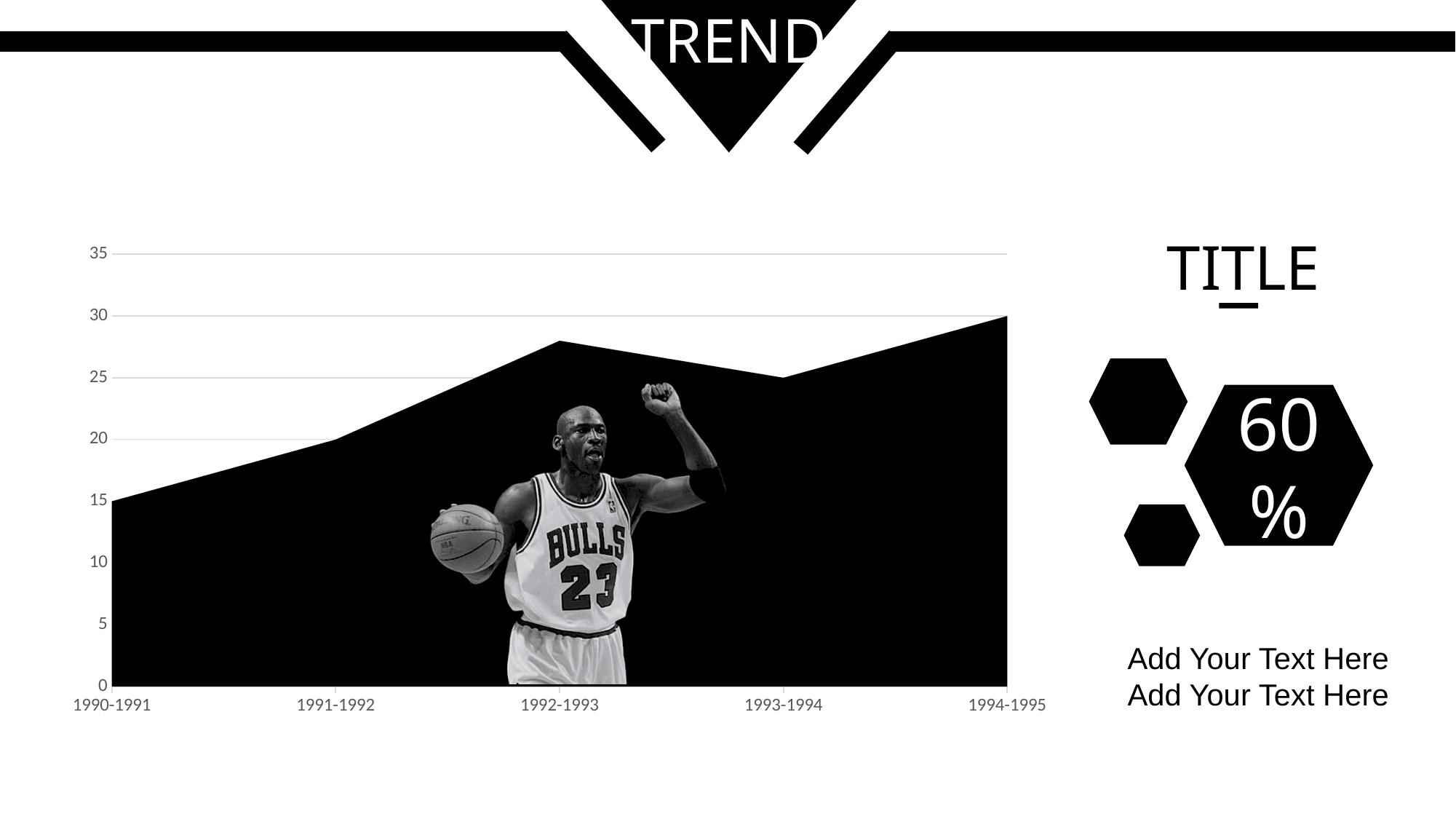
What kind of chart is shown on the slide? area chart What is the difference between the values for 1994-1995 and 1990-1991? 15 Do the values generally rise or fall from 1990-1991 to 1994-1995? rise What is the value for 1994-1995? 30 What is the value for 1991-1992? 20 Which is larger, the value for 1991-1992 or the value for 1993-1994? 1993-1994 What is the value for 1990-1991? 15 Is the value for 1992-1993 greater or less than 25? greater How many seasons are plotted along the x axis of the chart? 5 What is the value for 1993-1994? 25 Which season has the highest value? 1994-1995 Which season has the lowest value? 1990-1991